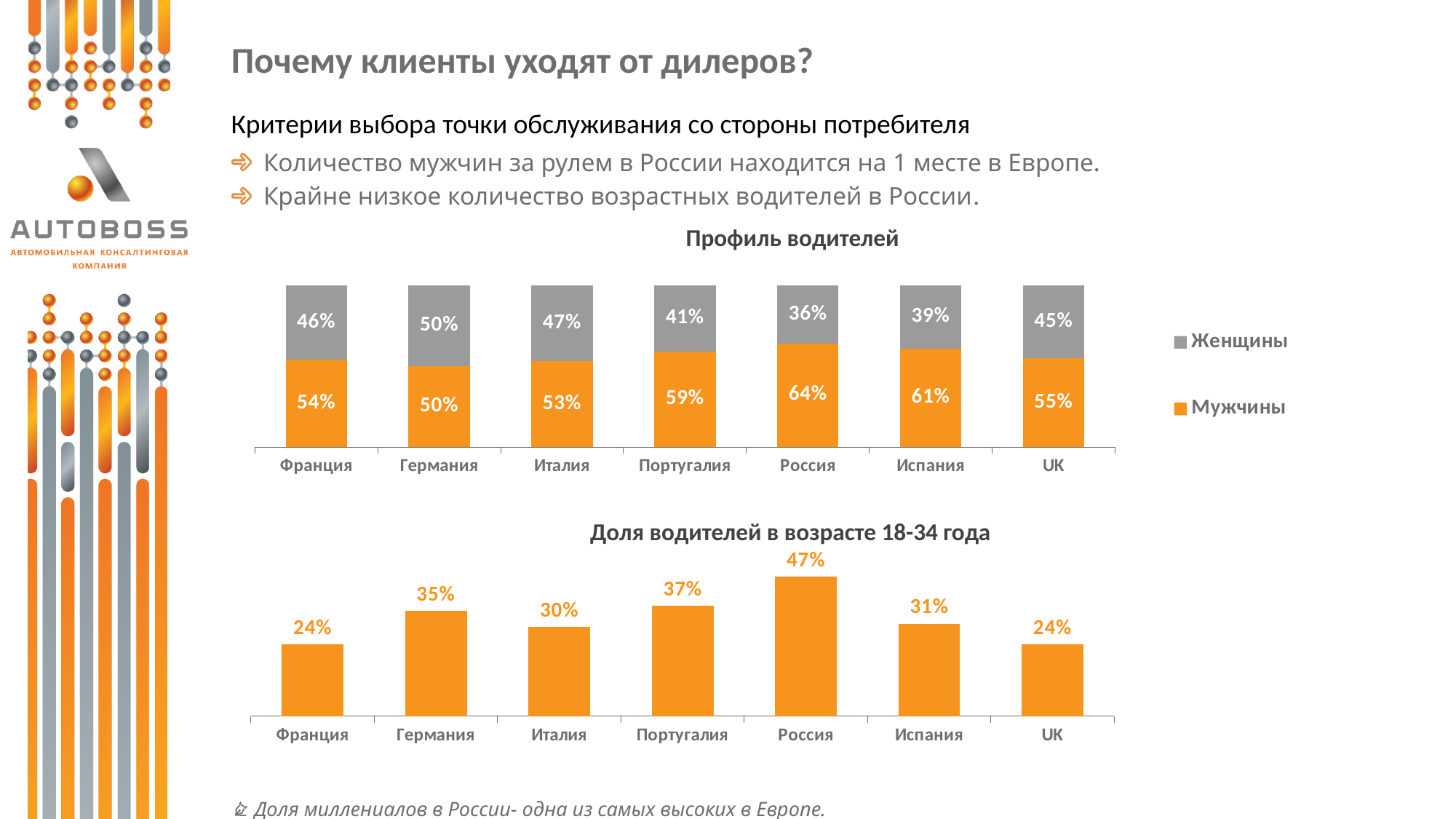
In the 'Профиль водителей' chart, which country has the highest share of Мужчины? Россия How many countries are shown in the 'Доля водителей в возрасте 18-34 года' chart? 7 In the 'Профиль водителей' chart, what is the difference between the Мужчины values for Испания and Франция? 7% In the 'Профиль водителей' chart, how many series does the legend list? 2 In the 'Профиль водителей' chart, what is the total of the stacked bar for Португалия? 100% In the 'Профиль водителей' chart, which country has the lowest share of Женщины? Россия In the 'Профиль водителей' chart, what is the value for Мужчины in Россия? 64% In the 'Доля водителей в возрасте 18-34 года' chart, what is the difference between Россия and UK? 23% In the 'Доля водителей в возрасте 18-34 года' chart, what is the value for Германия? 35% In the 'Профиль водителей' chart, what is the value for Женщины in Германия? 50% In the 'Доля водителей в возрасте 18-34 года' chart, which is larger, Португалия or Италия? Португалия In the 'Доля водителей в возрасте 18-34 года' chart, which country has the highest value? Россия